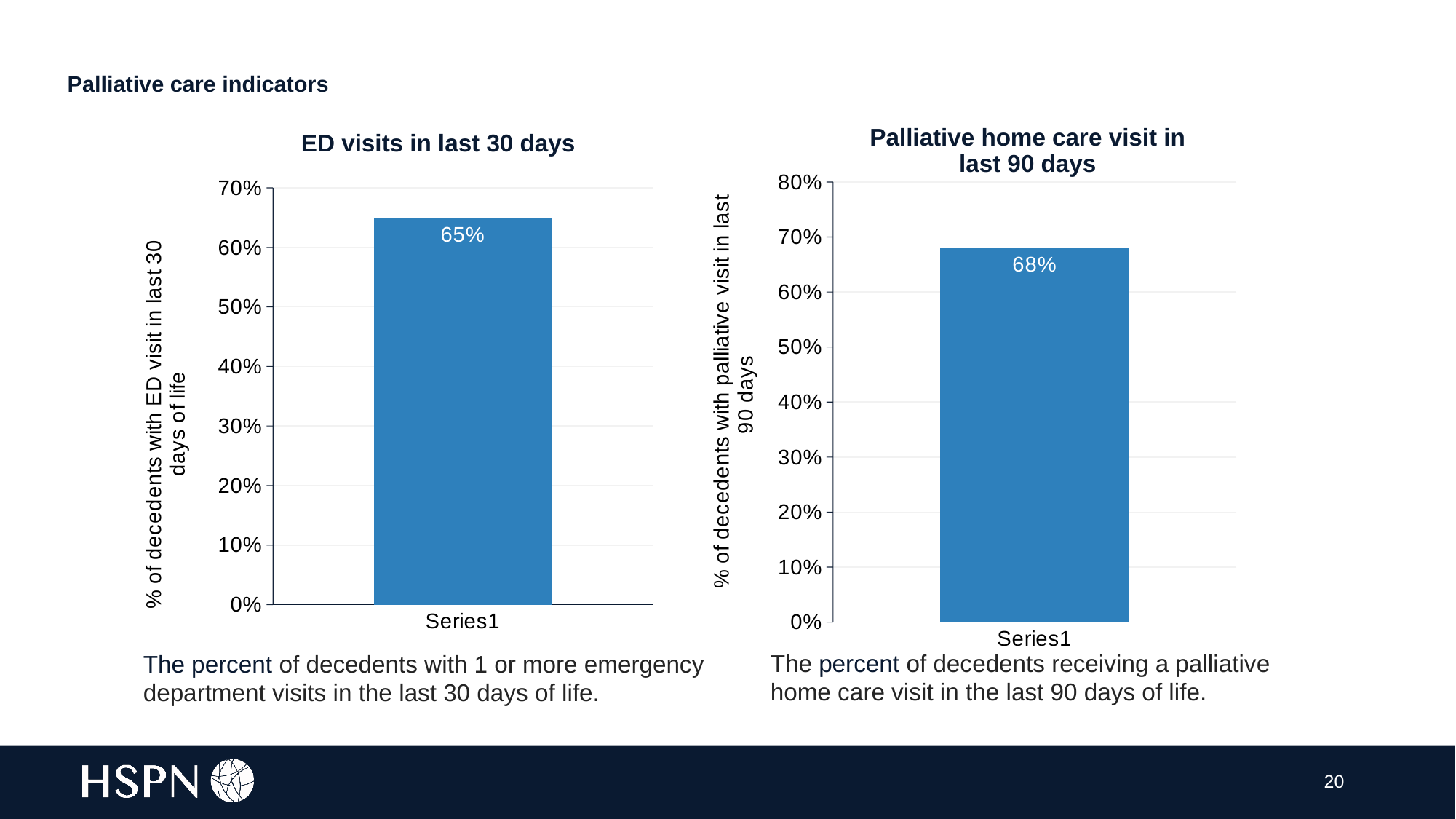
In the 'ED visits in last 30 days' chart, what value is shown for Series1? 65% In the 'ED visits in last 30 days' chart, is the value for Series1 greater or less than 60%? greater What is the highest value shown on the y axis of the 'Palliative home care visit in last 90 days' chart? 80% What kind of chart is 'Palliative home care visit in last 90 days'? bar chart What is the difference between the value in the 'Palliative home care visit in last 90 days' chart and the value in the 'ED visits in last 30 days' chart? 3% What is the y-axis label of the 'ED visits in last 30 days' chart? % of decedents with ED visit in last 30 days of life How many bars are plotted in the 'ED visits in last 30 days' chart? 1 In the 'Palliative home care visit in last 90 days' chart, is the value for Series1 greater or less than 70%? less In the 'Palliative home care visit in last 90 days' chart, what value is shown for Series1? 68% What kind of chart is 'ED visits in last 30 days'? bar chart How many bars are plotted in the 'Palliative home care visit in last 90 days' chart? 1 Which chart shows the larger value: 'ED visits in last 30 days' or 'Palliative home care visit in last 90 days'? Palliative home care visit in last 90 days